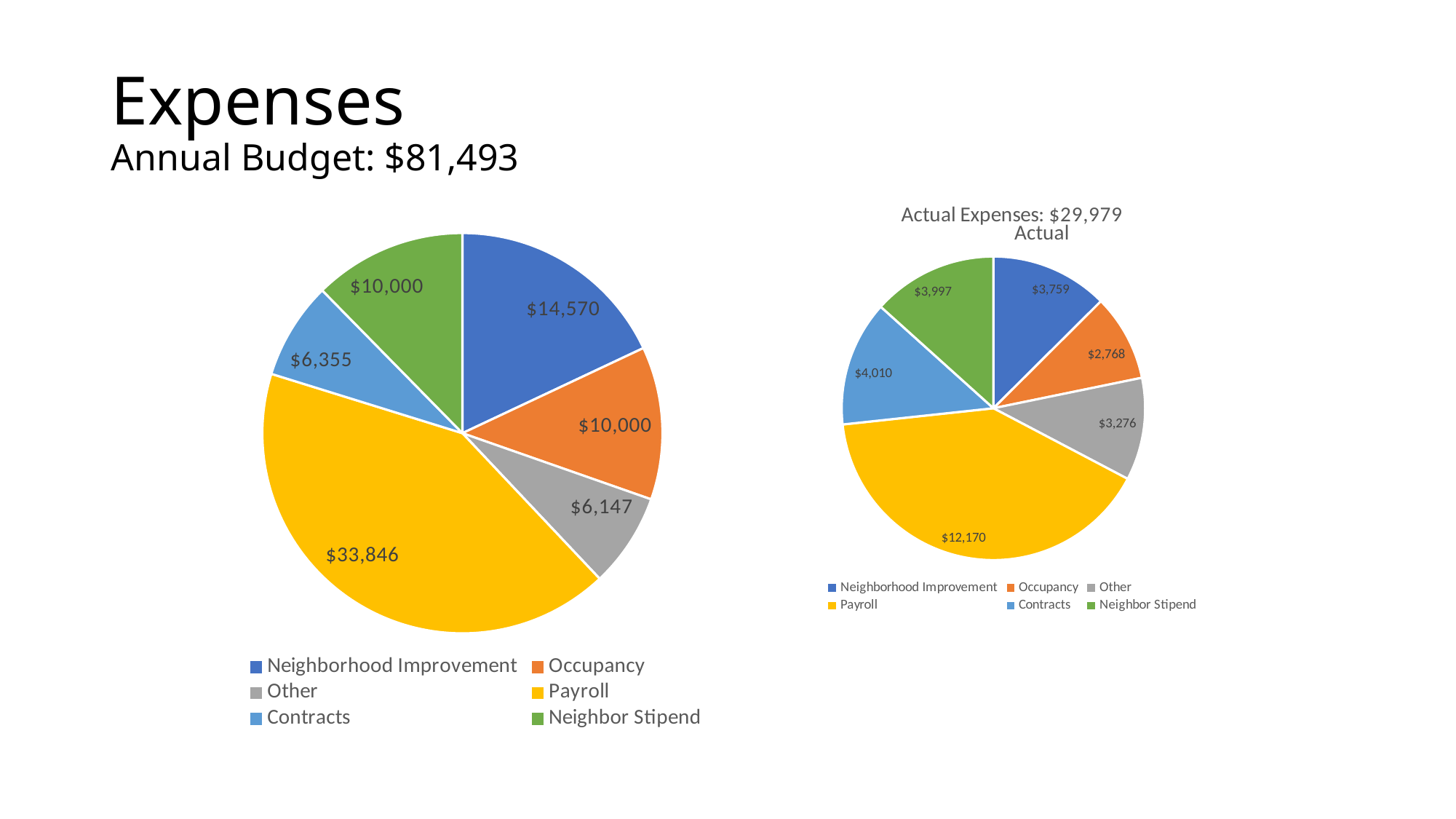
How many categories does the legend of the right pie chart (Actual Expenses) list? 6 In the right pie chart (Actual Expenses), what is the difference between Payroll and Contracts? $8,160 In the right pie chart (Actual Expenses), what is the value for Neighborhood Improvement? $3,759 In the right pie chart (Actual Expenses), what is the value for Other? $3,276 In the right pie chart (Actual Expenses), which category has the smallest value? Occupancy In the left pie chart (Annual Budget), which category has the smallest value? Other In the left pie chart (Annual Budget), what is the difference between Payroll and Neighborhood Improvement? $19,276 In the left pie chart (Annual Budget), what is the value for Payroll? $33,846 What type of chart is used on the left side of the slide? Pie chart In the right pie chart (Actual Expenses), which is larger, Contracts or Neighbor Stipend? Contracts In the left pie chart (Annual Budget), which category has the largest slice? Payroll In the left pie chart (Annual Budget), what is the value for Contracts? $6,355